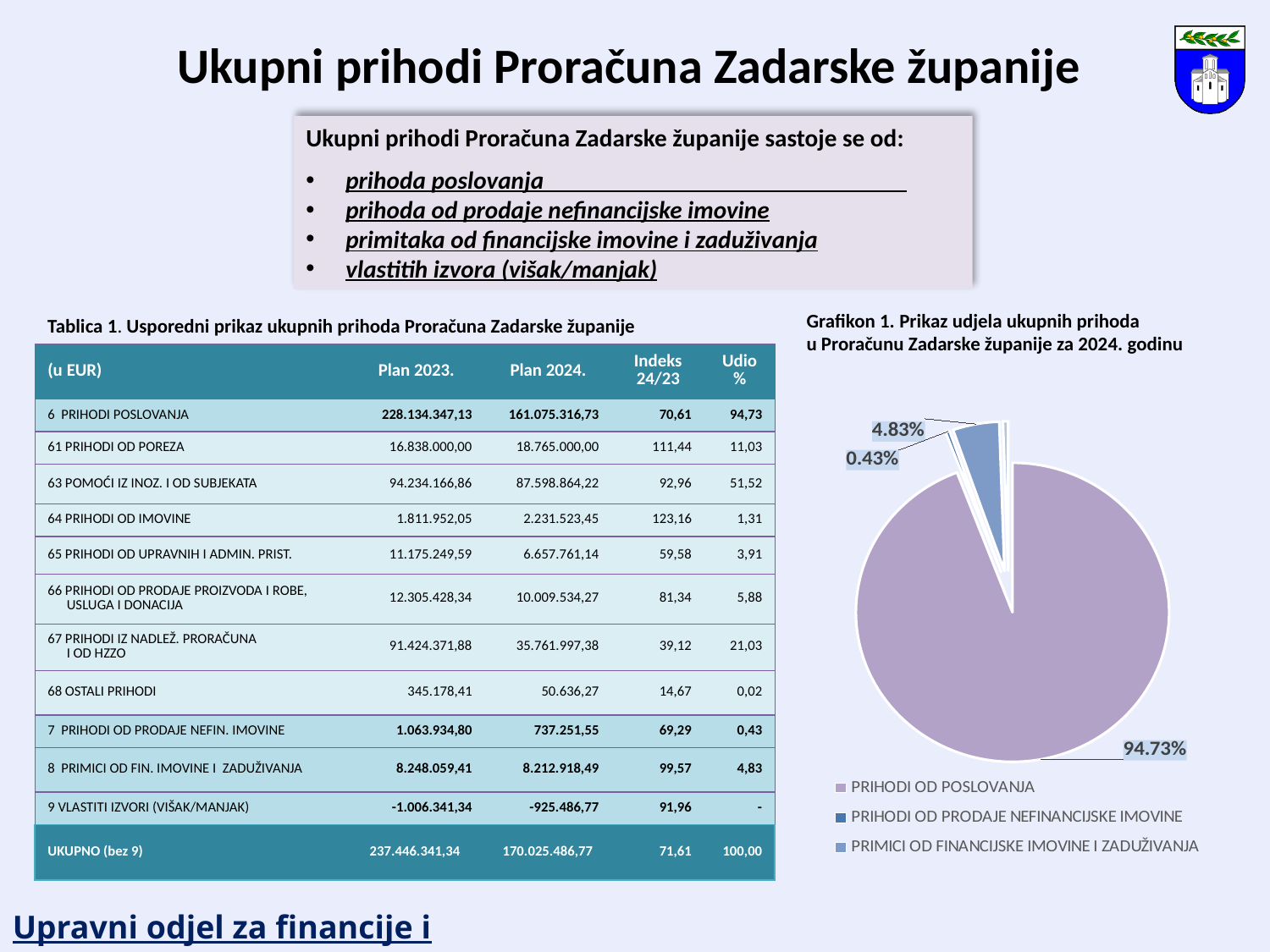
Which category has the largest slice of the pie? PRIHODI OD POSLOVANJA Which is larger in the pie chart: PRIMICI OD FINANCIJSKE IMOVINE I ZADUŽIVANJA or PRIHODI OD PRODAJE NEFINANCIJSKE IMOVINE? PRIMICI OD FINANCIJSKE IMOVINE I ZADUŽIVANJA Which category has the smallest slice of the pie? PRIHODI OD PRODAJE NEFINANCIJSKE IMOVINE How many entries does the legend of the pie chart list? 3 What share of the pie does PRIMICI OD FINANCIJSKE IMOVINE I ZADUŽIVANJA have? 4.83% Which legend entry is listed first in the pie chart's legend? PRIHODI OD POSLOVANJA What share of the pie does PRIHODI OD PRODAJE NEFINANCIJSKE IMOVINE have? 0.43% What share of the pie does PRIHODI OD POSLOVANJA have? 94.73% What is the difference in percentage points between the PRIMICI OD FINANCIJSKE IMOVINE I ZADUŽIVANJA slice and the PRIHODI OD PRODAJE NEFINANCIJSKE IMOVINE slice? 4.40 What is the title of the pie chart? Grafikon 1. Prikaz udjela ukupnih prihoda u Proračunu Zadarske županije za 2024. godinu What kind of chart is shown on the slide? pie chart